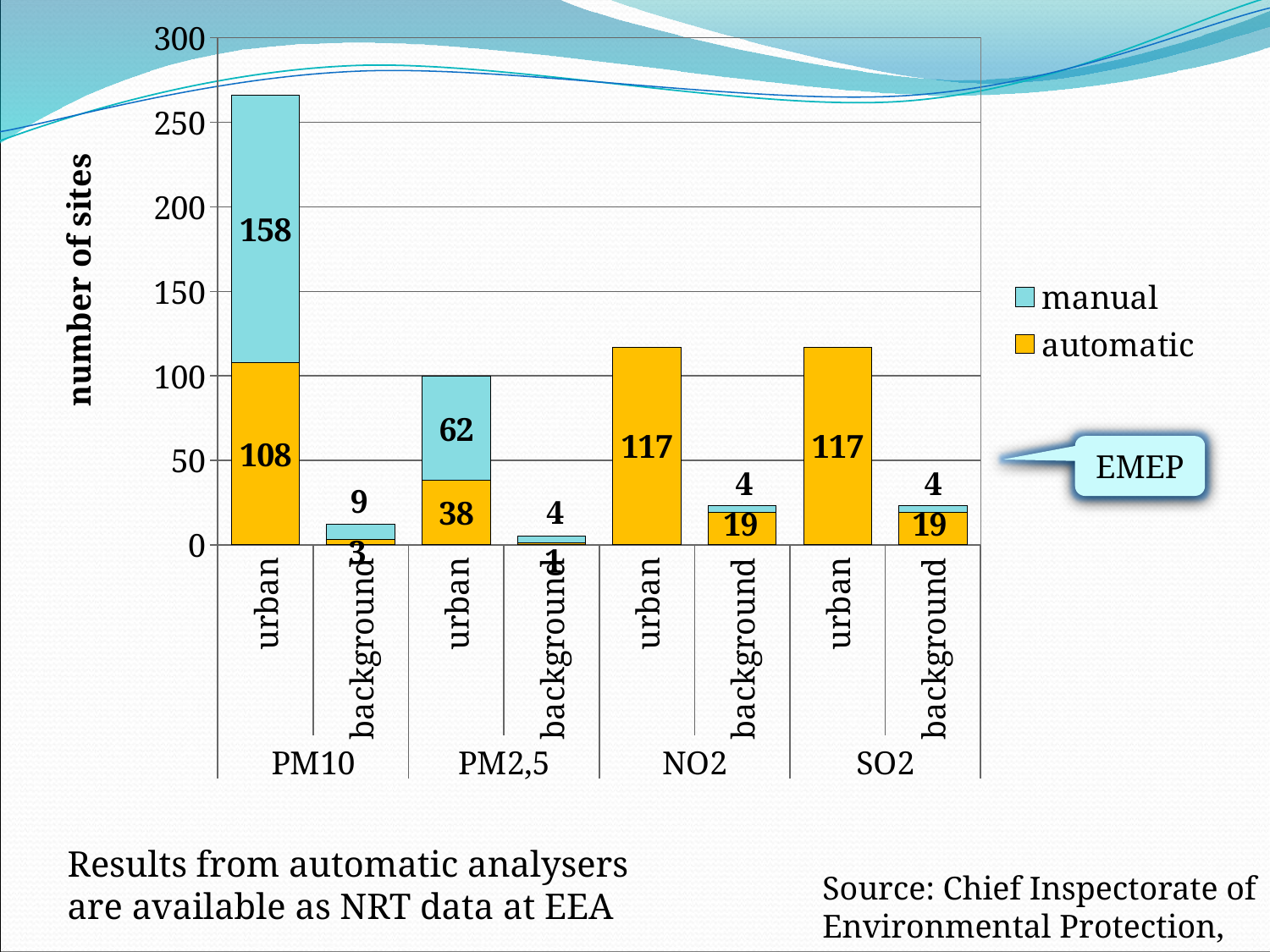
What is the total number of sites (manual plus automatic) for PM2,5 urban? 100 What is the difference between the manual sites for PM10 urban and the manual sites for PM2,5 urban? 96 What is the label on the vertical axis? number of sites How many series does the legend list? 2 Is the total height of the PM10 urban bar greater or less than 250? greater What is the number of automatic sites for PM2,5 urban? 38 Which category has the tallest stacked bar? PM10 urban How many manual sites are shown for PM10 urban? 158 How many automatic sites are shown for NO2 urban? 117 What is the total number of sites (manual plus automatic) for NO2 background? 23 Which has more automatic sites, PM10 urban or NO2 urban? NO2 urban What kind of chart is shown on the slide? Stacked bar chart